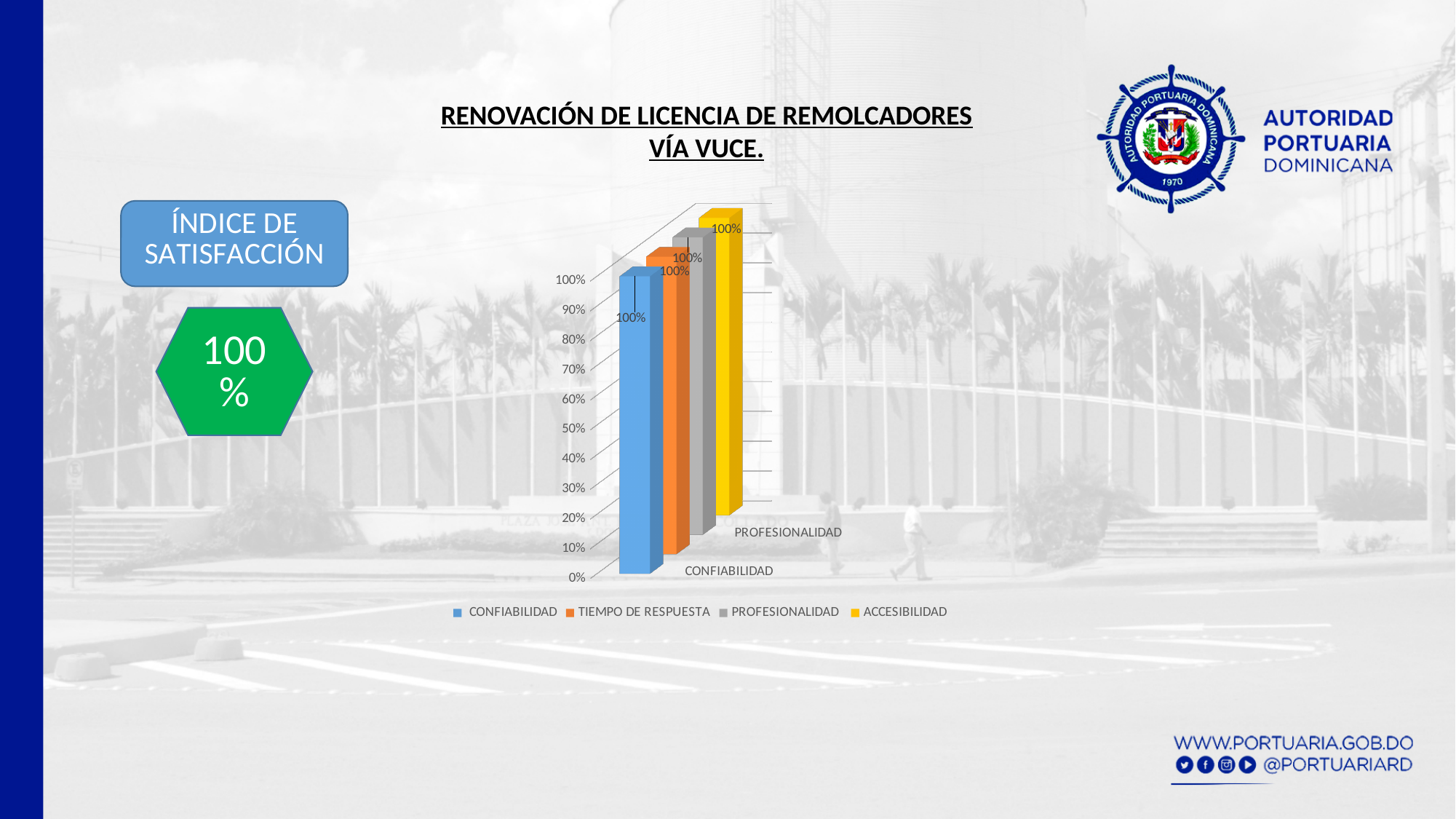
What is the value for CONFIABILIDAD? 100% What is the value for ACCESIBILIDAD? 100% What is the value for PROFESIONALIDAD? 100% What is the title of the chart? RENOVACIÓN DE LICENCIA DE REMOLCADORES VÍA VUCE. How many series does the legend list? 4 Is the value for PROFESIONALIDAD greater or less than 90%? greater Which series is shown in yellow in the legend? ACCESIBILIDAD What is the value for TIEMPO DE RESPUESTA? 100% How many bars are plotted in the chart? 4 What is the difference between the values for CONFIABILIDAD and ACCESIBILIDAD? 0% What kind of chart is shown on the slide? Bar chart